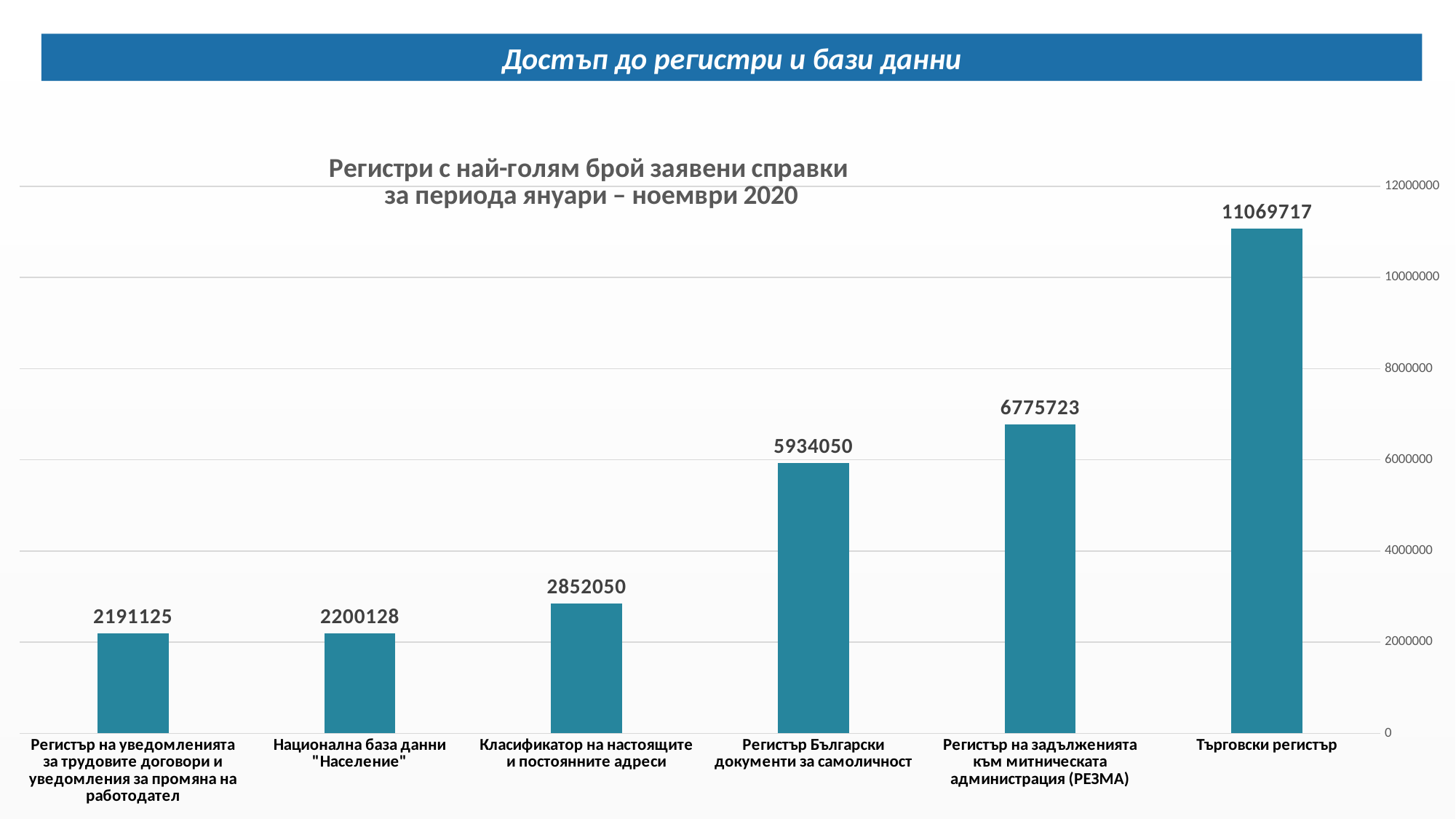
What is the value for Търговски регистър? 11069717 How many categories are shown in the chart? 6 What is the difference between the values for Регистър Български документи за самоличност and Класификатор на настоящите и постоянните адреси? 3082000 What is the value for Регистър Български документи за самоличност? 5934050 What is the value for Регистър на задълженията към митническата администрация (РЕЗМА)? 6775723 Which category has the lowest value? Регистър на уведомленията за трудовите договори и уведомления за промяна на работодател What is the difference between the values for Търговски регистър and Регистър на задълженията към митническата администрация (РЕЗМА)? 4293994 Which is larger: the value for Регистър Български документи за самоличност or the value for Регистър на задълженията към митническата администрация (РЕЗМА)? Регистър на задълженията към митническата администрация (РЕЗМА) Do the values rise or fall from left to right along the x axis? Rise What is the value for Класификатор на настоящите и постоянните адреси? 2852050 Which category has the highest value? Търговски регистър What type of chart is shown on the slide? Bar chart